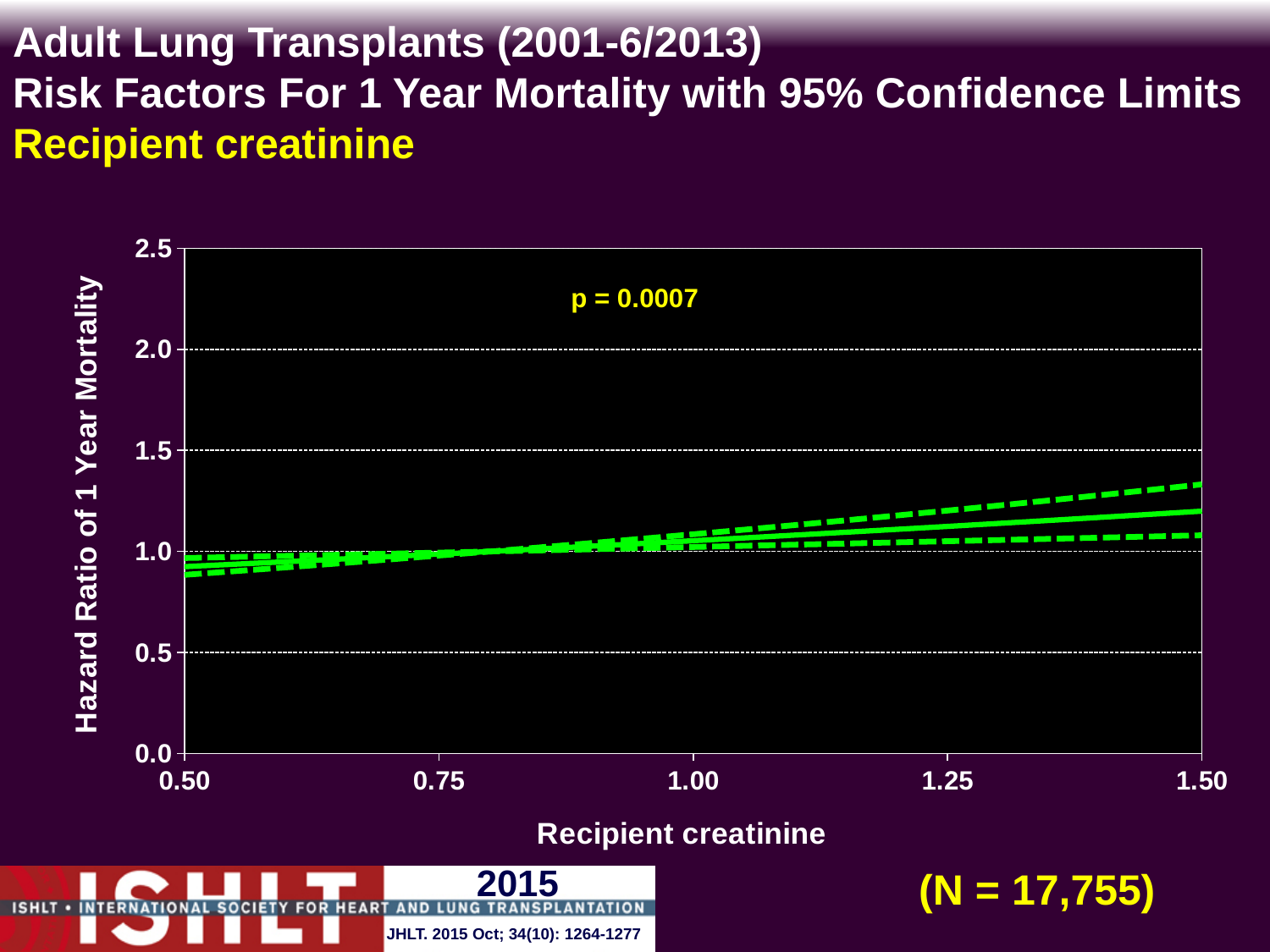
At a recipient creatinine of 1.50, is the hazard ratio (solid line) greater or less than 1.0? greater Does the hazard ratio of 1 year mortality rise or fall as recipient creatinine increases from 0.50 to 1.50? rise How many tick labels are shown on the x axis (Recipient creatinine)? 5 What is the sample size (N) shown on the slide? N = 17,755 What is the highest value labelled on the y axis? 2.5 What p-value is printed on the chart? p = 0.0007 At a recipient creatinine of 1.50, is the upper 95% confidence limit greater or less than 1.5? less At a recipient creatinine of 1.50, is the hazard ratio (solid line) greater or less than 1.5? less What kind of chart is shown on the slide? line chart Is the hazard ratio at a recipient creatinine of 1.50 larger or smaller than at 0.50? larger How many lines are plotted on the chart (the estimate plus its confidence limits)? 3